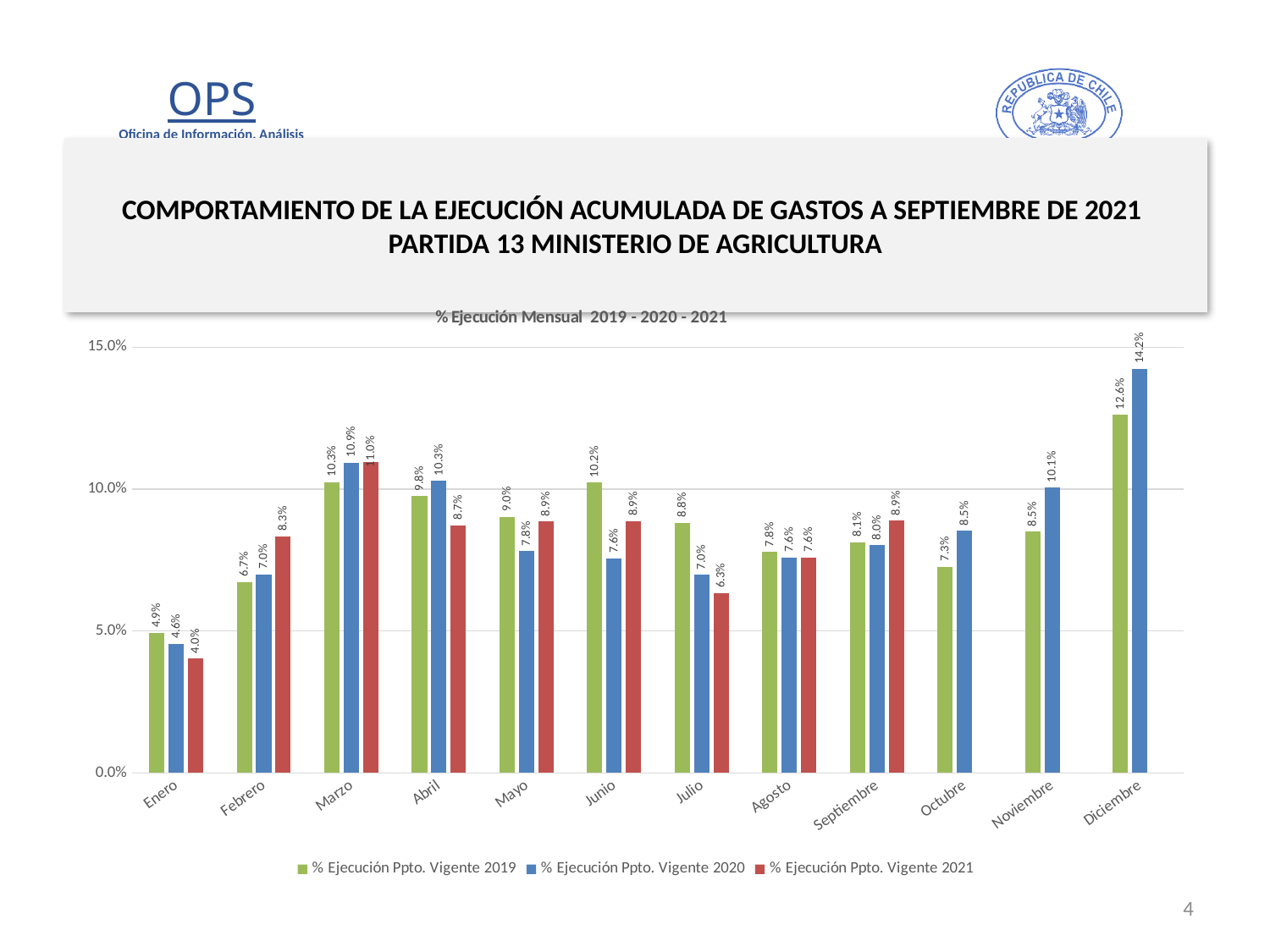
How many months are shown on the x axis? 12 What is the title of the chart? % Ejecución Mensual 2019 - 2020 - 2021 What is the value for % Ejecución Ppto. Vigente 2020 in Diciembre? 14.2% Which is larger in Julio: the 2019 value or the 2021 value? 2019 (8.8%) In which month is the % Ejecución Ppto. Vigente 2020 series highest? Diciembre Is the value for % Ejecución Ppto. Vigente 2019 in Enero greater or less than 5.0%? less What is the value for % Ejecución Ppto. Vigente 2021 in Marzo? 11.0% What is the difference between the 2020 and 2019 values in Diciembre? 1.6% What is the value for % Ejecución Ppto. Vigente 2019 in Junio? 10.2% In which month is the % Ejecución Ppto. Vigente 2021 series lowest? Enero What kind of chart is shown on the slide? Bar chart How many series does the legend list? 3